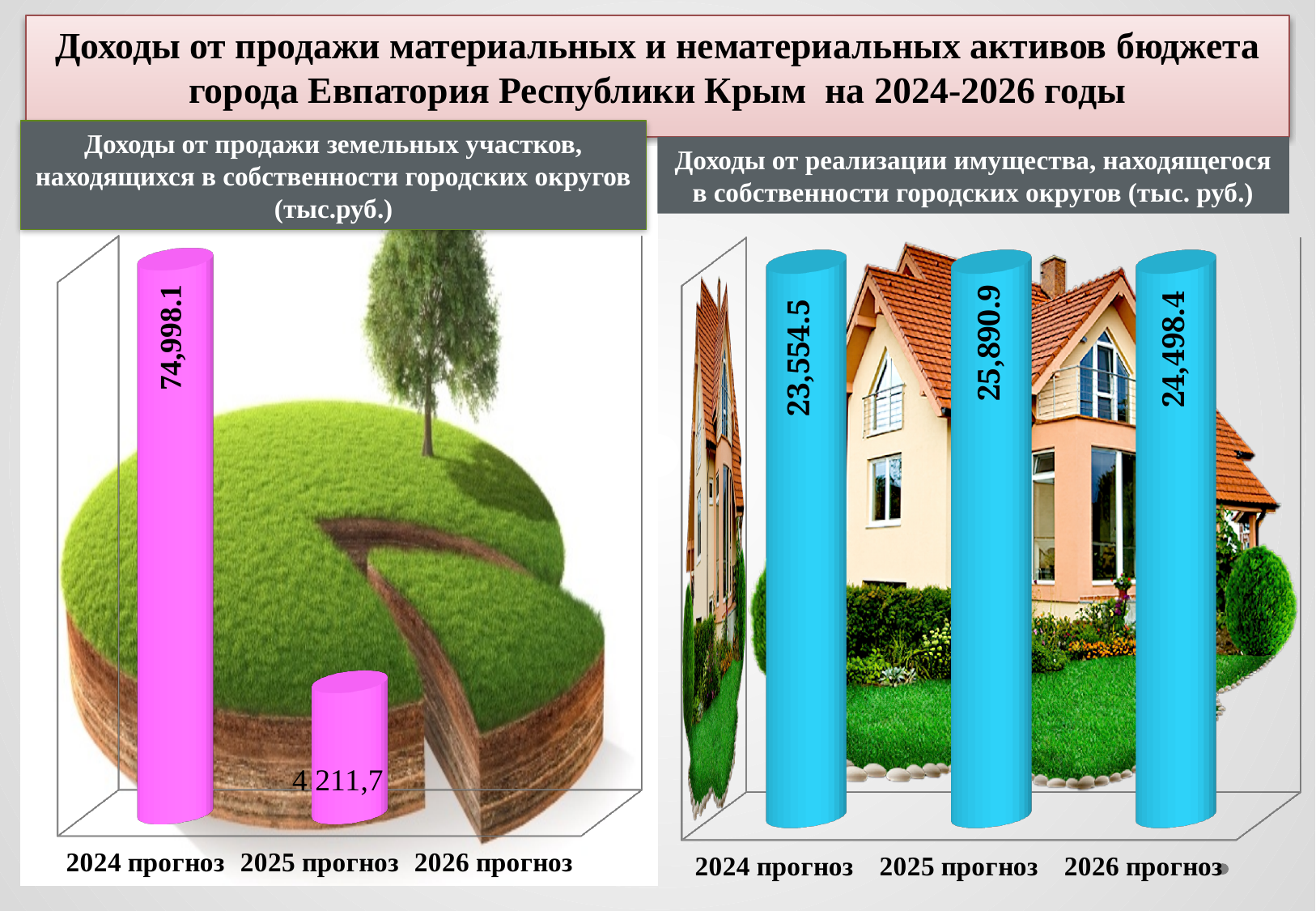
In the right chart (Доходы от реализации имущества), what is the value for 2026 прогноз? 24,498.4 In the left chart (Доходы от продажи земельных участков), what is the value for 2025 прогноз? 4 211,7 In the right chart (Доходы от реализации имущества), what is the difference between the 2025 прогноз and 2024 прогноз values? 2,336.4 In the right chart (Доходы от реализации имущества), what is the value for 2024 прогноз? 23,554.5 In the right chart (Доходы от реализации имущества), which is larger: the value for 2026 прогноз or 2024 прогноз? 2026 прогноз How many year categories are labelled on the x axis of the right chart (Доходы от реализации имущества)? 3 In the right chart (Доходы от реализации имущества), what is the value for 2025 прогноз? 25,890.9 In the left chart (Доходы от продажи земельных участков), what is the value for 2024 прогноз? 74,998.1 In the right chart (Доходы от реализации имущества), which year has the highest value? 2025 прогноз In the left chart (Доходы от продажи земельных участков), which is larger: the value for 2024 прогноз or 2025 прогноз? 2024 прогноз What type of chart is the right chart (Доходы от реализации имущества)? Bar chart In the right chart (Доходы от реализации имущества), which year has the lowest value? 2024 прогноз